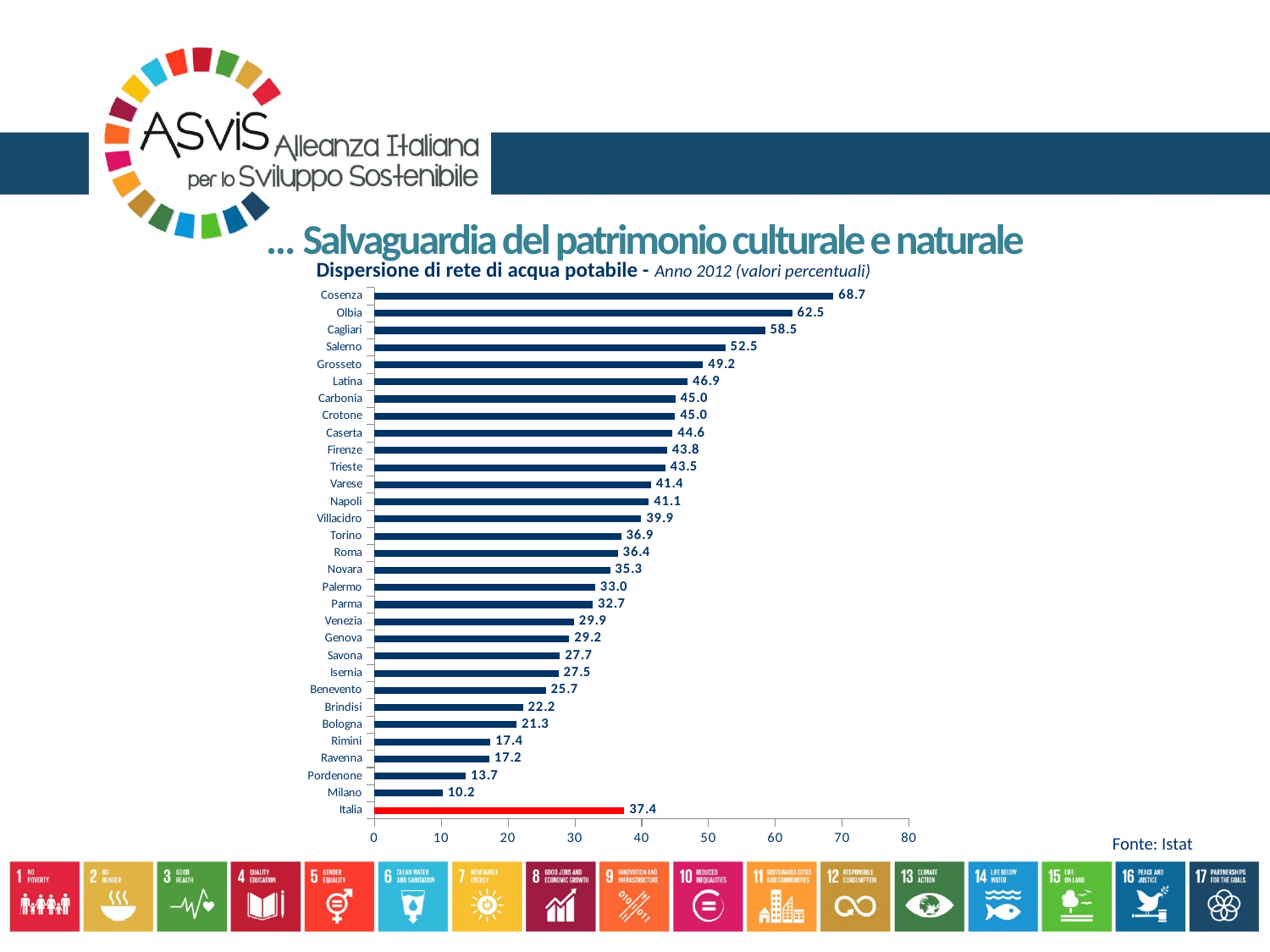
Which city has the highest value? Cosenza Which city has the lowest value? Milano What is the difference between the value for Italia and the value for Milano? 27.2 Which is larger, the value for Roma or the value for Torino? Torino Is the value for Salerno greater or less than 50? greater What is the value for Cosenza? 68.7 What is the difference between the values for Olbia and Cagliari? 4.0 How many categories are plotted on the chart? 31 What kind of chart is shown? bar chart Which bar is coloured red instead of dark blue? Italia What is the value for Italia? 37.4 What is the value for Milano? 10.2